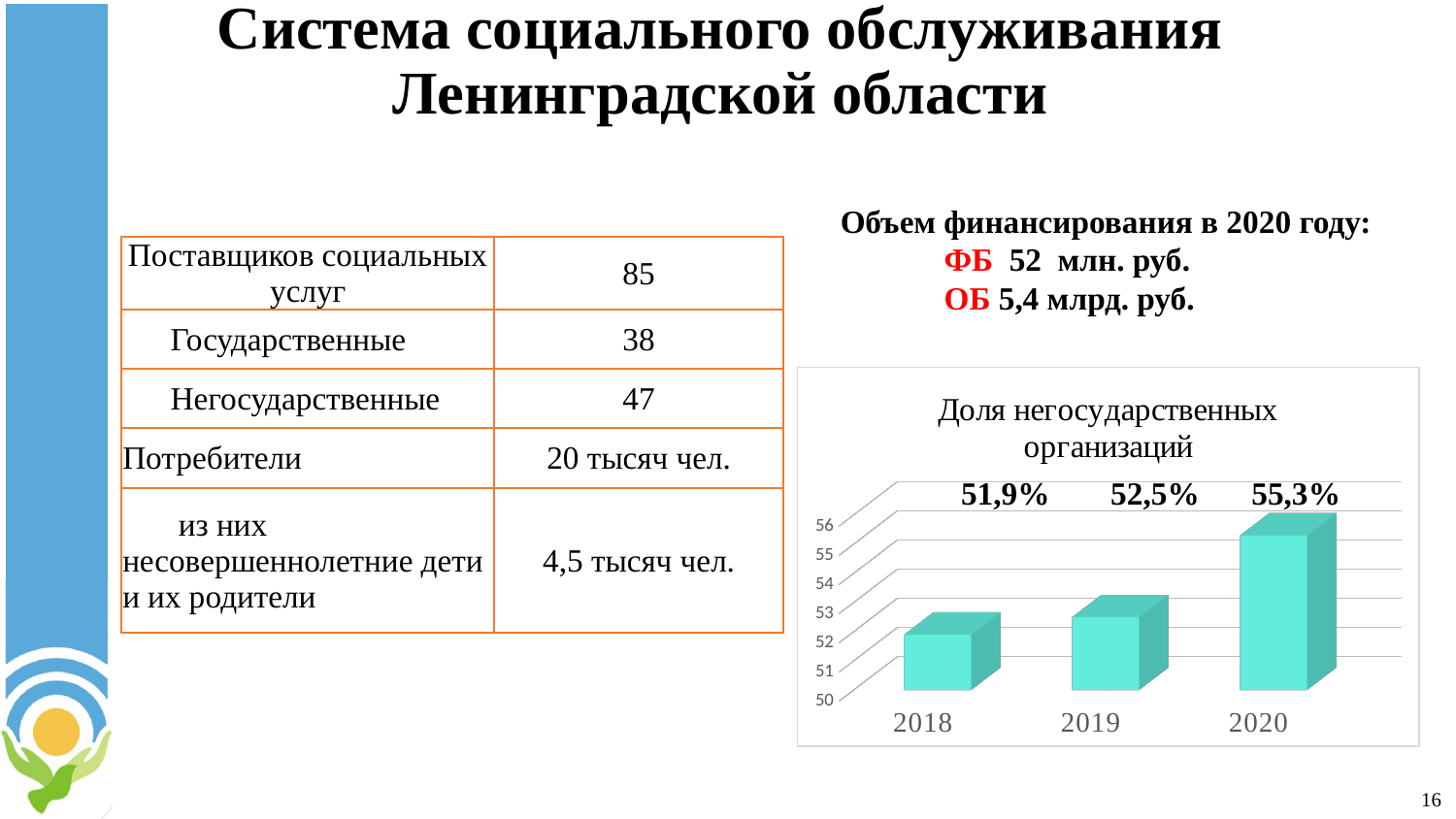
How many years are shown on the x axis of the chart? 3 Which year has the highest value in the chart? 2020 Which year has the lowest value in the chart? 2018 Do the values rise or fall from 2018 to 2020? rise What is the value for 2019 in the chart? 52,5% What kind of chart is shown on the slide? bar chart What is the title of the chart on the slide? Доля негосударственных организаций What is the value for 2018 in the chart? 51,9% What is the difference between the values for 2020 and 2019? 2,8% What is the value for 2020 in the chart? 55,3% What is the difference between the values for 2019 and 2018? 0,6% Which is larger, the value for 2019 or the value for 2020? 2020